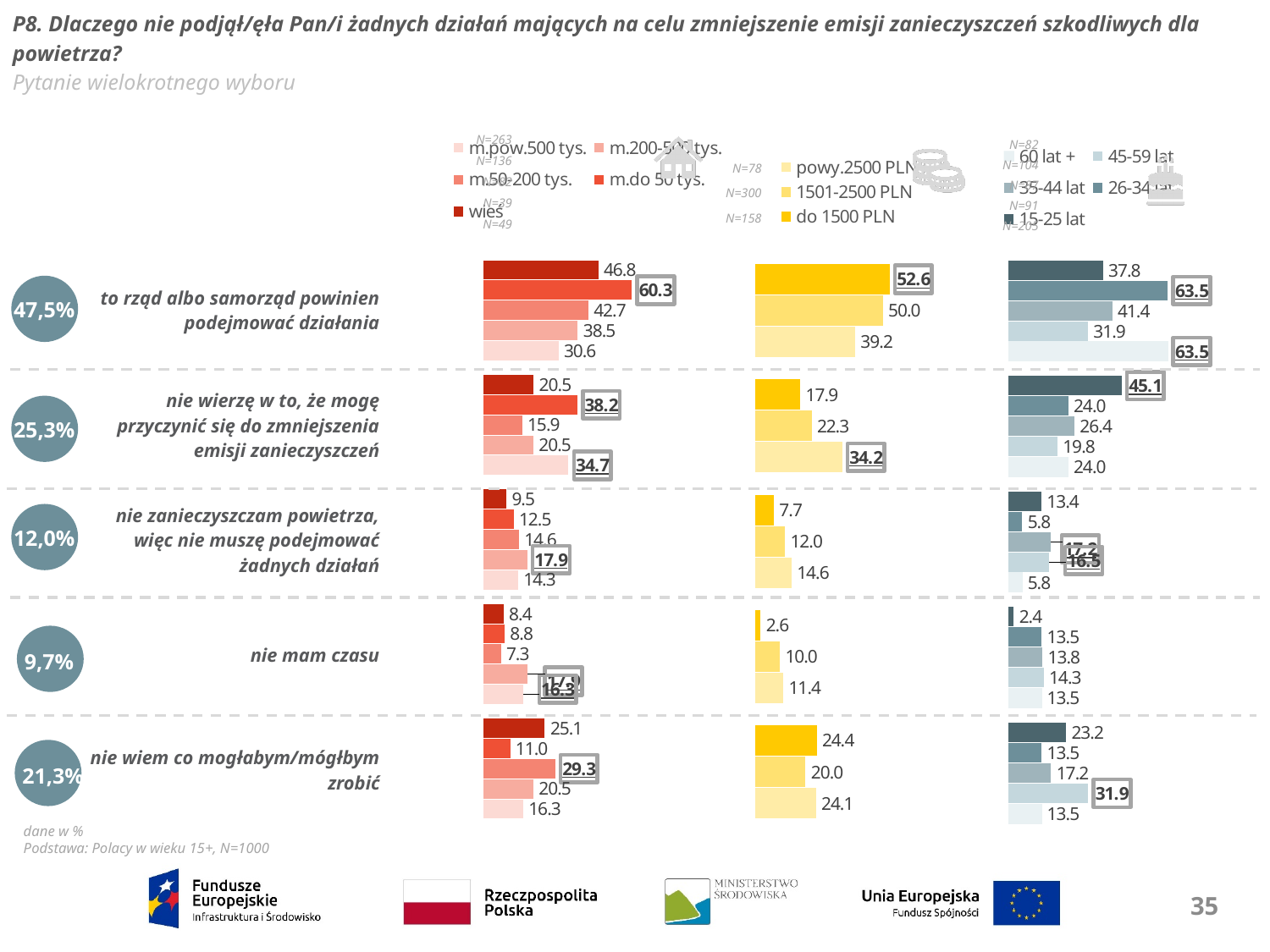
In the income-group chart (do 1500 PLN / 1501-2500 PLN / powy.2500 PLN), what is the value for 'do 1500 PLN' for the reason 'to rząd albo samorząd powinien podejmować działania'? 52.6 In the place-of-residence chart, which residence category has the highest value for the reason 'to rząd albo samorząd powinien podejmować działania'? m.do 50 tys. In the income-group chart, what is the value for 'powy.2500 PLN' for the reason 'nie wierzę w to, że mogę przyczynić się do zmniejszenia emisji zanieczyszczeń'? 34.2 In the income-group chart, what is the difference between 'do 1500 PLN' and 'powy.2500 PLN' for the reason 'to rząd albo samorząd powinien podejmować działania'? 13.4 In the age-group chart, which is larger for the reason 'nie wierzę w to, że mogę przyczynić się do zmniejszenia emisji zanieczyszczeń': the value for '15-25 lat' or for '45-59 lat'? 15-25 lat What type of chart is used on this slide to show the results by place of residence, income and age? bar chart In the place-of-residence chart, what is the value for 'wieś' for the reason 'nie wiem co mogłabym/mógłbym zrobić'? 25.1 How many income groups does the legend of the income-group chart list? 3 In the age-group chart, what is the value for '45-59 lat' for the reason 'nie wiem co mogłabym/mógłbym zrobić'? 31.9 How many age groups does the legend of the age-group chart list? 5 What overall percentage is shown in the circle next to the reason 'nie mam czasu'? 9,7% In the income-group chart, which income group has the lowest value for the reason 'nie mam czasu'? do 1500 PLN